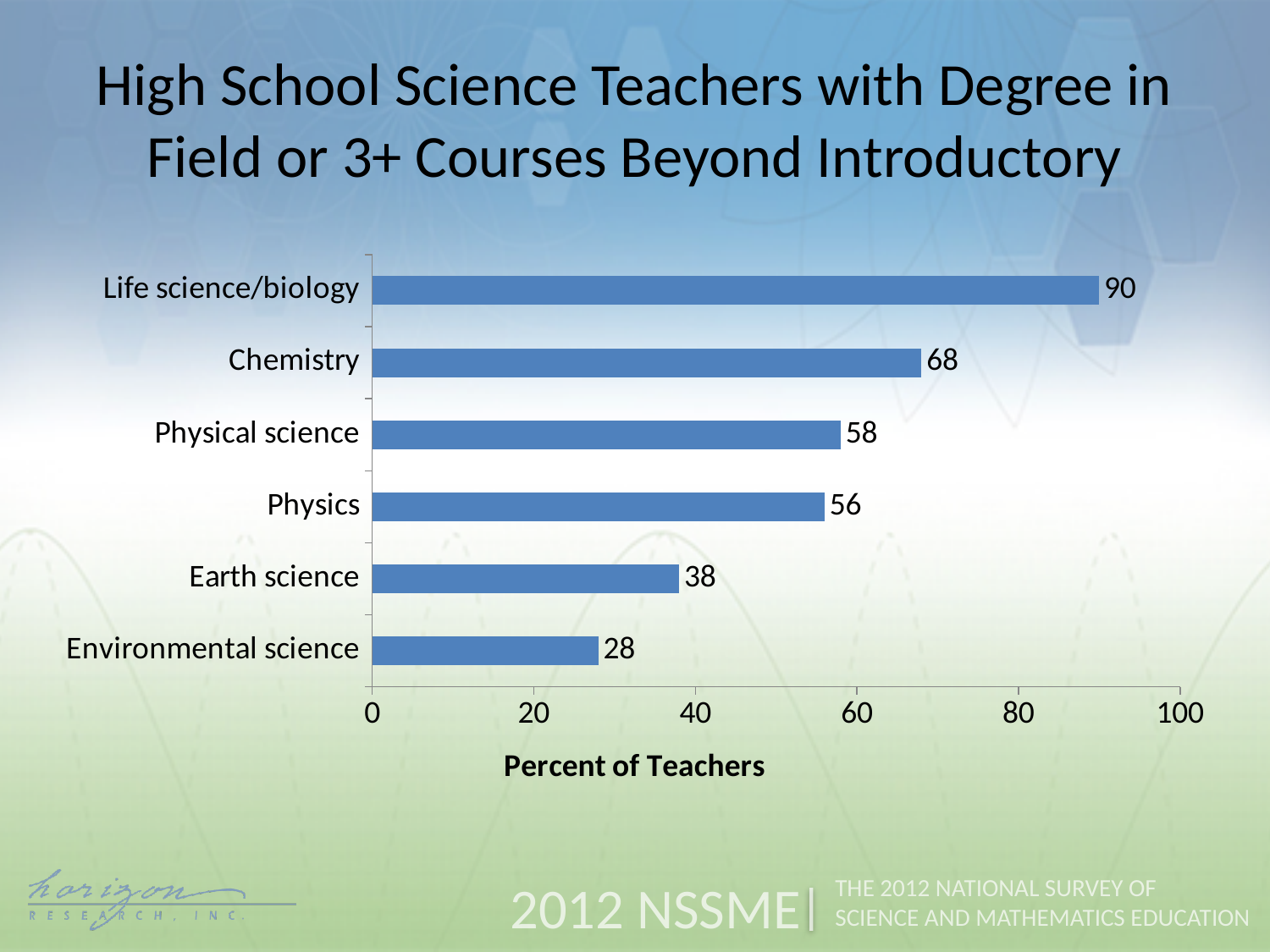
Which category has the highest value? Life science/biology Which category has the lowest value? Environmental science What kind of chart is shown on the slide? bar chart Is the value for Physics greater or less than 40? greater What is the difference between the values for Life science/biology and Chemistry? 22 What is the difference between the values for Earth science and Environmental science? 10 What is the value for Earth science? 38 What is the label of the horizontal axis? Percent of Teachers Which is larger, the value for Physical science or the value for Earth science? Physical science What is the value for Life science/biology? 90 How many categories are shown in the chart? 6 What is the value for Chemistry? 68